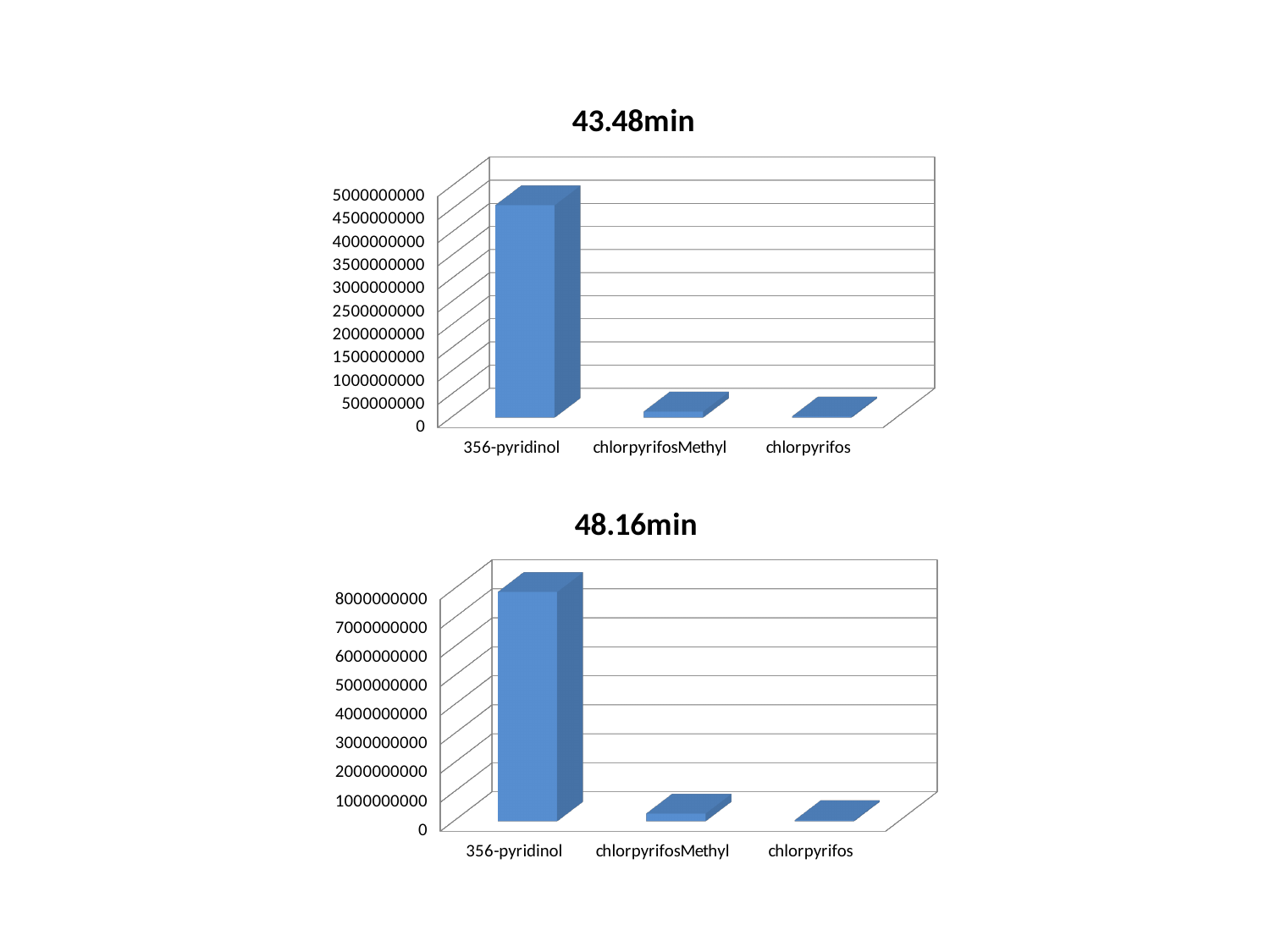
What is the title of the top chart on the slide? 43.48min In the chart titled 43.48min, what kind of chart is shown? bar chart In the chart titled 48.16min, which category has the highest value? 356-pyridinol In the chart titled 48.16min, is the value for chlorpyrifosMethyl greater or less than 1000000000? less In the chart titled 43.48min, which is larger, the value for 356-pyridinol or the value for chlorpyrifos? 356-pyridinol In the chart titled 43.48min, how many categories are shown on the x axis? 3 In the chart titled 48.16min, which category has the lowest value? chlorpyrifos In the chart titled 48.16min, is the value for 356-pyridinol greater or less than 7000000000? greater In the chart titled 43.48min, which category has the highest value? 356-pyridinol In the chart titled 43.48min, is the value for 356-pyridinol greater or less than 4000000000? greater What is the title of the bottom chart on the slide? 48.16min